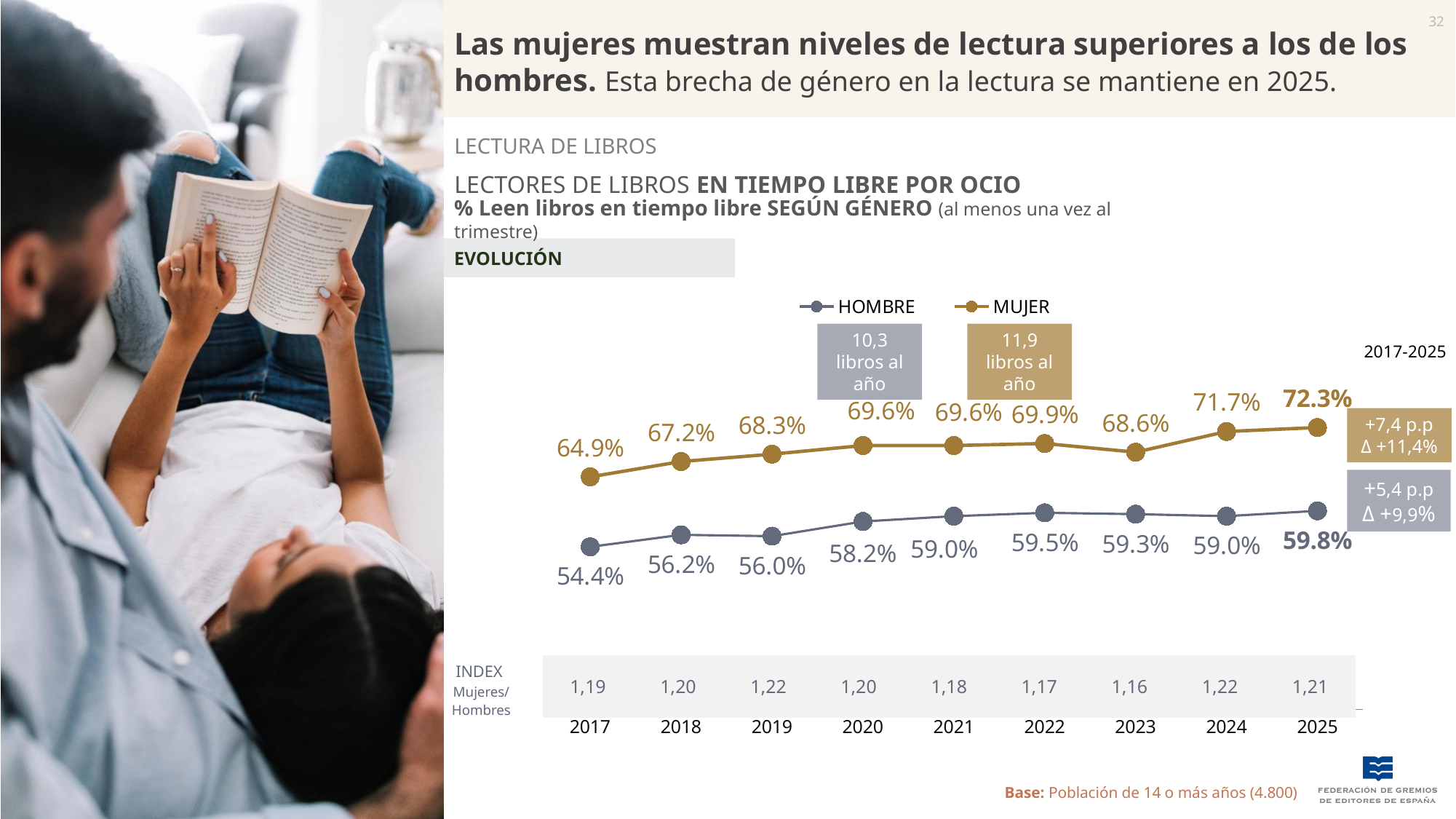
What is the value for MUJER in 2023? 68.6% How many series does the legend list? 2 In which year is the HOMBRE series at its highest? 2025 Does the HOMBRE series rise or fall from 2017 to 2025 overall? Rise In which year is the MUJER series at its lowest? 2017 What is the value for MUJER in 2025? 72.3% What is the value for HOMBRE in 2022? 59.5% What is the value for HOMBRE in 2017? 54.4% What is the difference between the MUJER and HOMBRE values in 2025? 12.5 percentage points Which series has the higher value in 2020, HOMBRE or MUJER? MUJER What kind of chart is shown? Line chart How many years are plotted on the x axis? 9